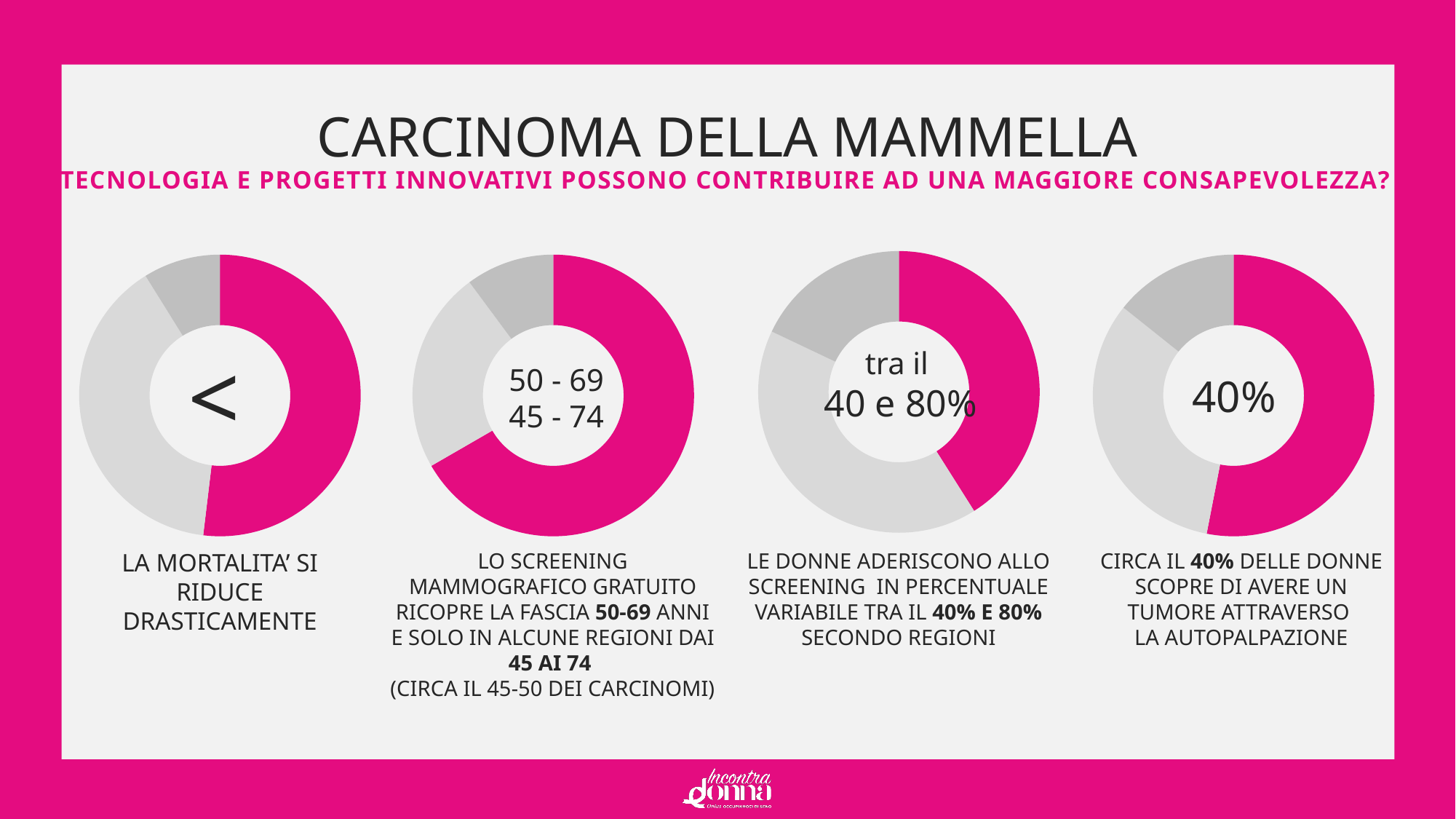
In the rightmost donut chart, which colour segment is the smallest? Dark grey In the rightmost donut chart ("CIRCA IL 40% DELLE DONNE"), is the pink segment larger or smaller than the light grey segment? Larger How many donut charts are shown on the slide? 4 In the leftmost donut chart ("LA MORTALITA' SI RIDUCE DRASTICAMENTE"), how many segments does the ring have? 3 What text is printed in the centre of the third donut chart from the left? tra il 40 e 80% In the third donut chart from the left ("LE DONNE ADERISCONO ALLO SCREENING"), which colour segment is the smallest? Dark grey In the second donut chart from the left ("LO SCREENING MAMMOGRAFICO GRATUITO"), which colour segment is the smallest? Dark grey In the leftmost donut chart ("LA MORTALITA' SI RIDUCE DRASTICAMENTE"), which colour segment is the largest? Pink What text is printed in the centre of the rightmost donut chart? 40% In the second donut chart from the left ("LO SCREENING MAMMOGRAFICO GRATUITO"), which colour segment is the largest? Pink What kind of chart is used for the four graphics on the slide? Donut (pie) chart